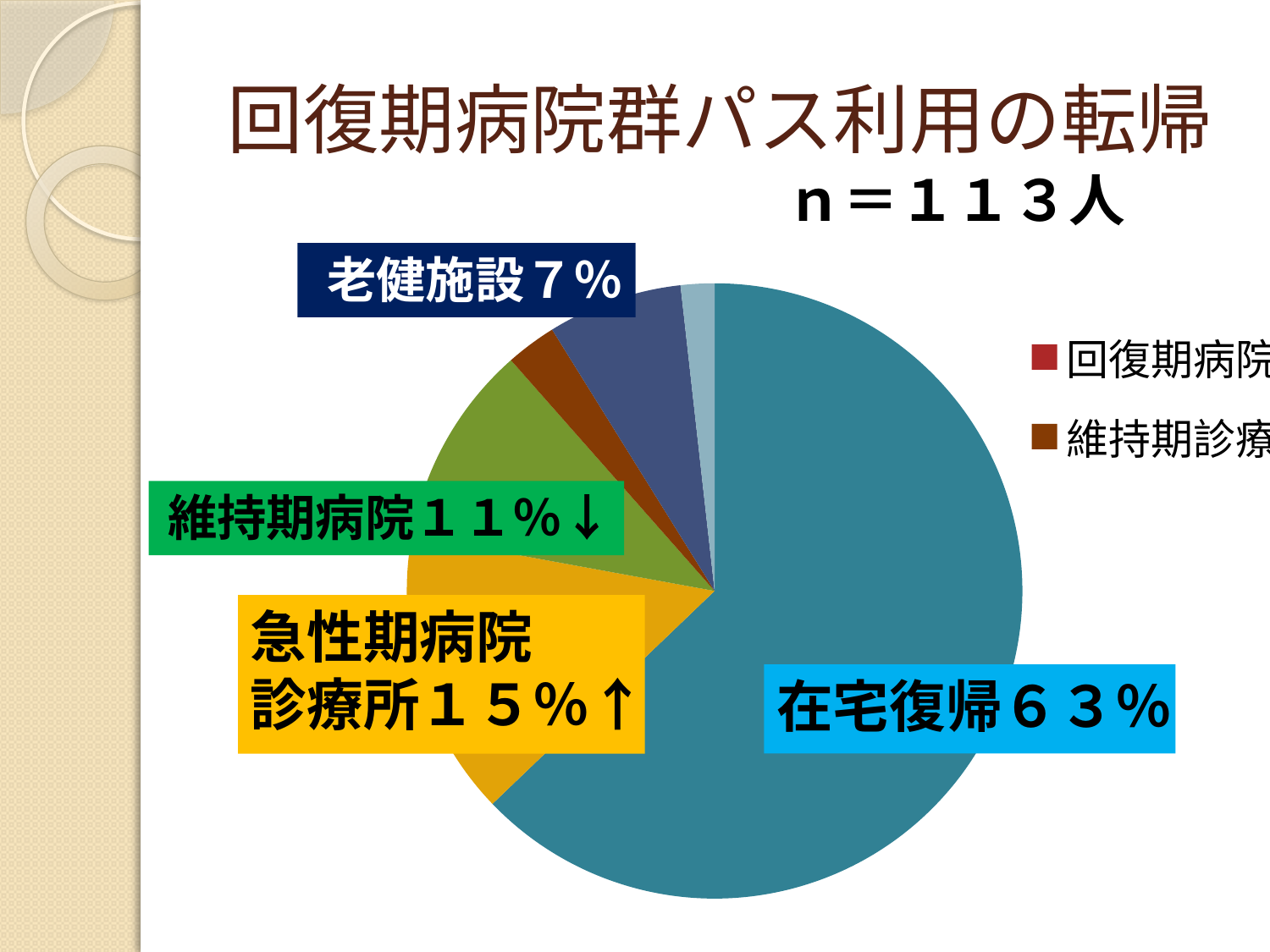
Which category has the largest share of the pie? 在宅復帰 What percentage is shown for 急性期病院診療所? 15% What is the difference in percentage points between 維持期病院 and 老健施設? 4 What is the title of the pie chart on the slide? 回復期病院群パス利用の転帰 How many slices does the pie chart have? 6 What percentage is shown for 老健施設? 7% What percentage of the pie is labelled 在宅復帰? 63% What is the total number of people (n) stated on the slide? 113人 What type of chart is shown on the slide? pie chart What percentage is shown for 維持期病院? 11% What is the difference in percentage points between 在宅復帰 and 急性期病院診療所? 48 Which is larger, the share for 急性期病院診療所 or the share for 維持期病院? 急性期病院診療所